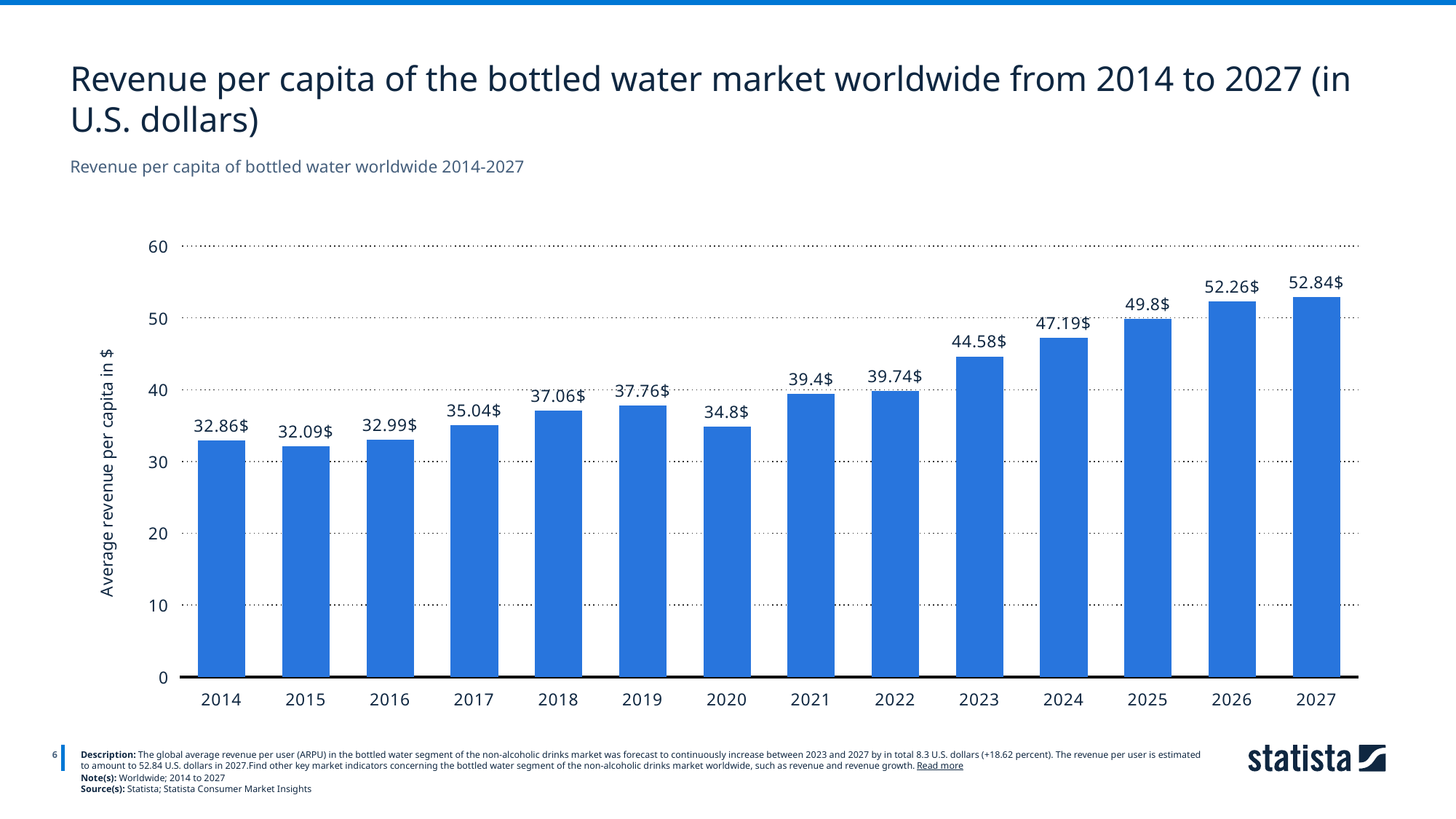
Do the values generally rise or fall from 2020 to 2027? Rise Is the value for 2025 greater or less than 50? less What is the revenue per capita of the bottled water market worldwide in 2014? 32.86$ What is the difference in revenue per capita between 2027 and 2026? 0.58$ Which year has the highest revenue per capita in the chart? 2027 How many years are shown on the x axis of the chart? 14 What is the revenue per capita of the bottled water market worldwide in 2020? 34.8$ What is the label of the y axis of the chart? Average revenue per capita in $ What kind of chart is shown on the slide? Bar chart Which year has a higher revenue per capita, 2019 or 2020? 2019 Which year has the lowest revenue per capita in the chart? 2015 What is the revenue per capita of the bottled water market worldwide in 2024? 47.19$